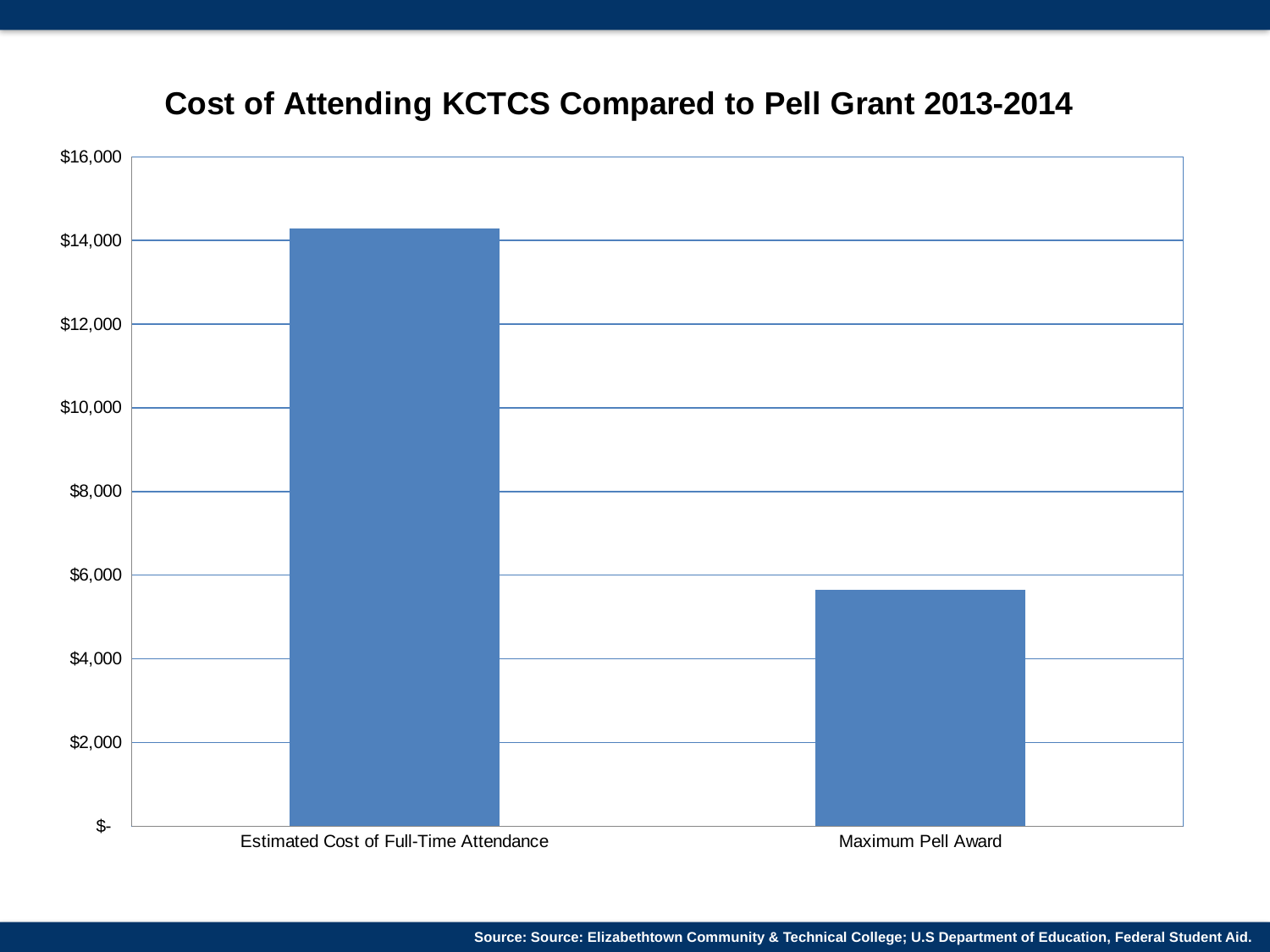
What is the title of the chart? Cost of Attending KCTCS Compared to Pell Grant 2013-2014 Which category has the lowest value? Maximum Pell Award Is the value for Estimated Cost of Full-Time Attendance greater or less than $16,000? less How many bars are plotted in the chart? 2 Is the value for Maximum Pell Award greater or less than $6,000? less Which category has the highest value? Estimated Cost of Full-Time Attendance Is the value for Estimated Cost of Full-Time Attendance greater or less than $14,000? greater What kind of chart is shown on the slide? bar chart Which is larger, the Estimated Cost of Full-Time Attendance or the Maximum Pell Award? Estimated Cost of Full-Time Attendance What is the highest value shown on the vertical axis? $16,000